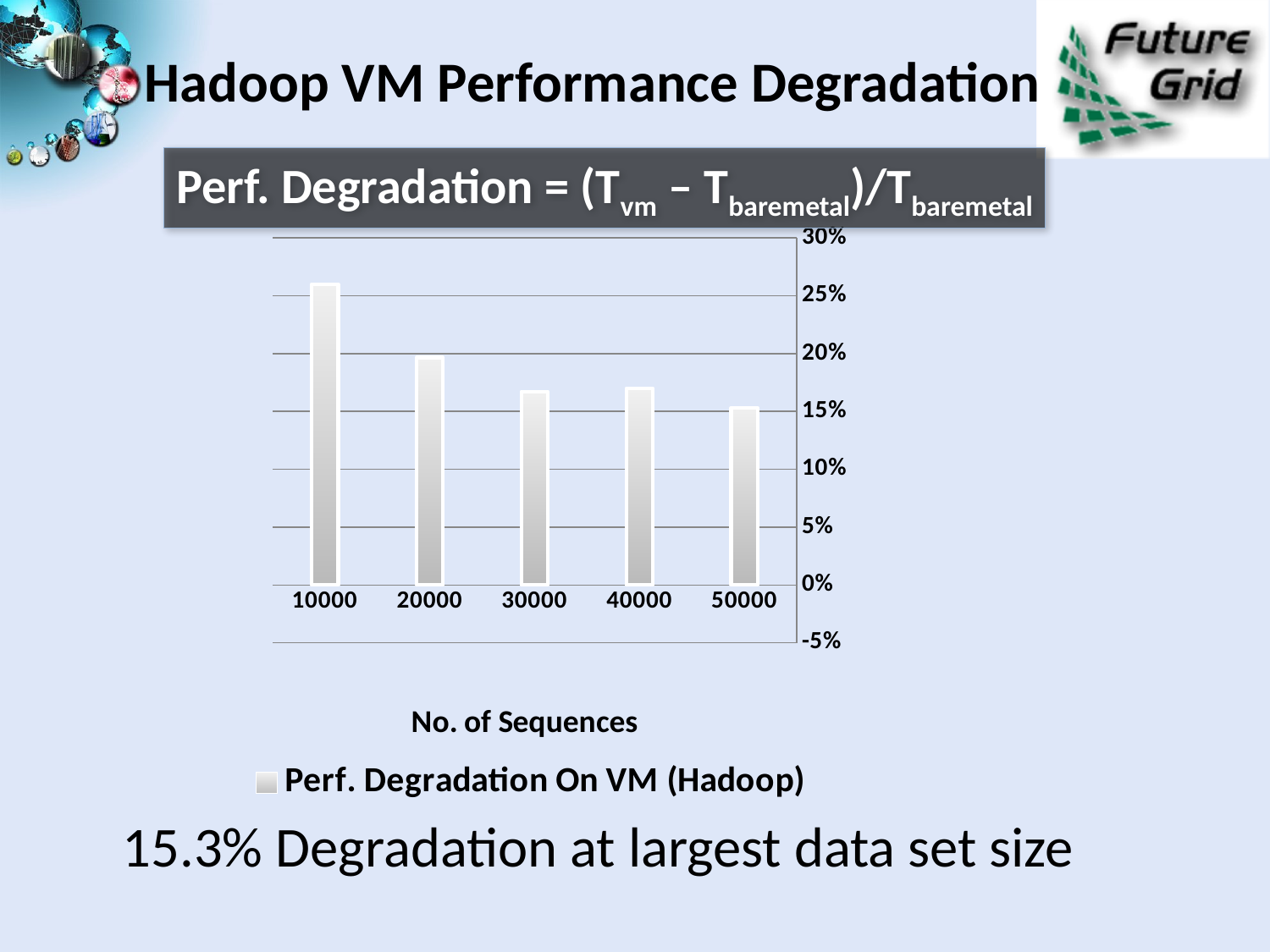
Does the performance degradation generally rise or fall as the number of sequences increases? fall Which number of sequences has the highest performance degradation? 10000 What is the performance degradation at the largest data set size (50000 sequences)? 15.3% Which has the larger performance degradation, 10000 or 20000 sequences? 10000 Is the value for 40000 sequences greater or less than 15%? greater Is the value for 30000 sequences greater or less than 20%? less Is the value for 10000 sequences greater or less than 20%? greater How many series does the legend list? 1 Which number of sequences has the lowest performance degradation? 50000 How many categories (numbers of sequences) are plotted on the x axis? 5 What kind of chart is shown on the slide? bar chart